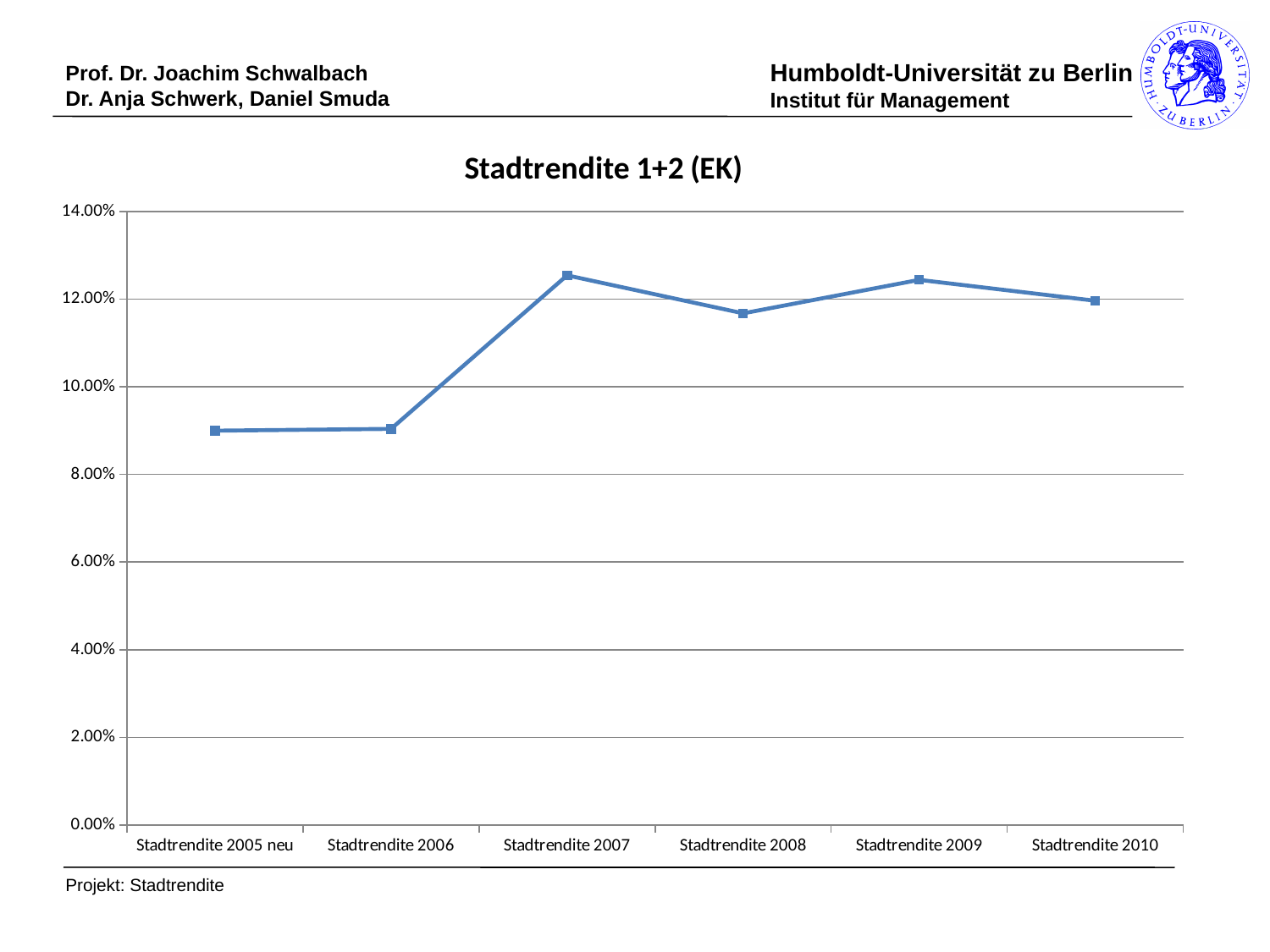
What is the title of the chart? Stadtrendite 1+2 (EK) Which is larger, the value for Stadtrendite 2007 or Stadtrendite 2008? Stadtrendite 2007 Is the value for Stadtrendite 2005 neu greater or less than 10.00%? less Is the value for Stadtrendite 2006 greater or less than 8.00%? greater Does the line rise or fall between Stadtrendite 2006 and Stadtrendite 2007? rise Which is larger, the value for Stadtrendite 2006 or Stadtrendite 2010? Stadtrendite 2010 Is the value for Stadtrendite 2007 greater or less than 12.00%? greater How many data points are plotted on the line? 6 What is the highest value shown on the vertical axis? 14.00% What kind of chart is shown on the slide? line chart